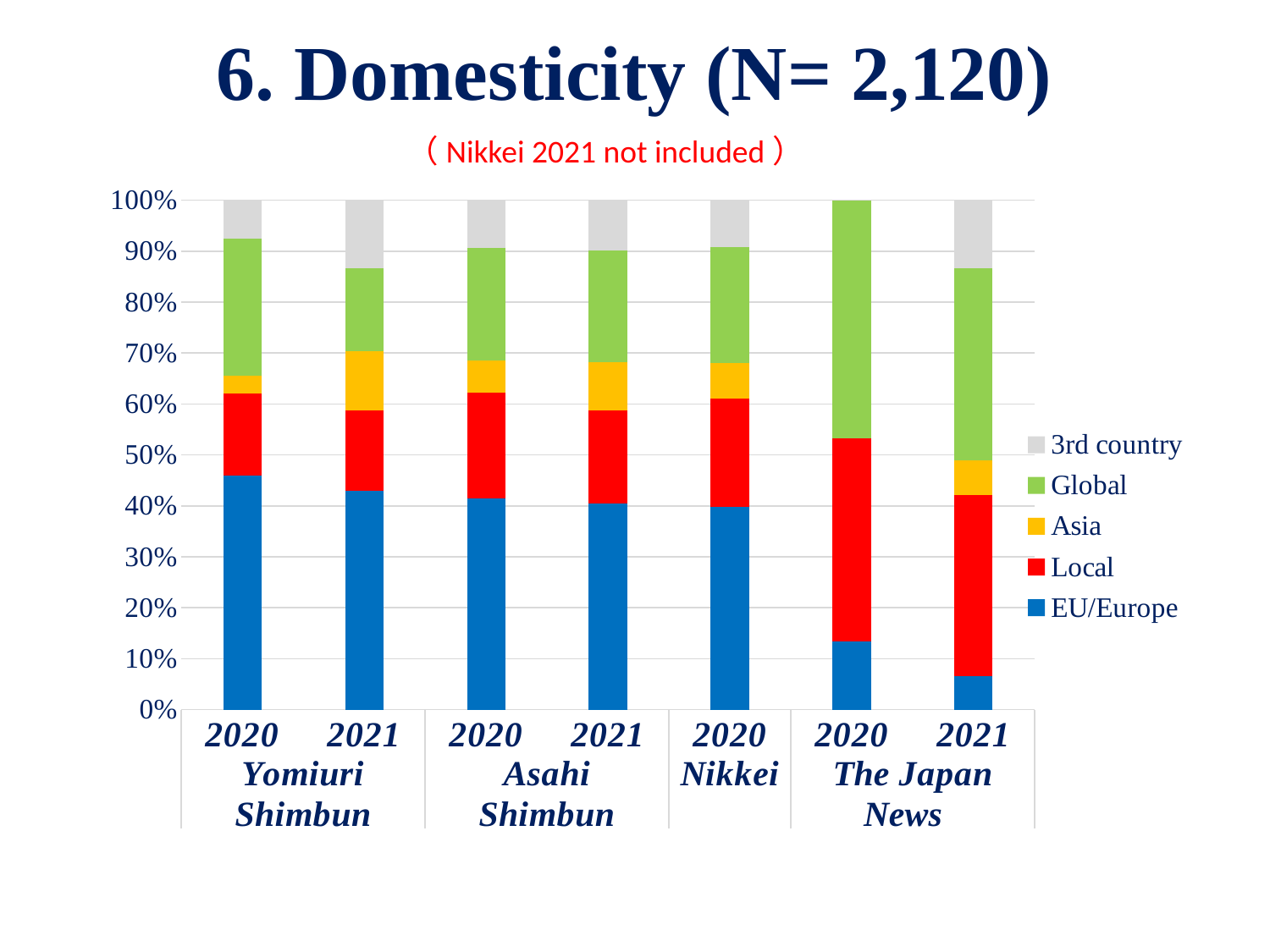
Which bar has no 3rd country segment? The Japan News 2020 Which has the larger Local segment: The Japan News 2020 or Asahi Shimbun 2020? The Japan News 2020 Is the EU/Europe share for Yomiuri Shimbun 2020 greater or less than 40%? greater How many bars are plotted in the chart? 7 Is the EU/Europe share for The Japan News 2021 greater or less than 10%? less Which newspaper and year has the smallest EU/Europe segment? The Japan News 2021 What kind of chart is shown on the slide? Stacked bar chart Which newspaper and year has the largest Local segment? The Japan News 2020 Which year of Nikkei is noted as not included in the chart? 2021 Is the EU/Europe share for The Japan News 2020 greater or less than 10%? greater Which has the larger EU/Europe segment: Yomiuri Shimbun 2020 or The Japan News 2020? Yomiuri Shimbun 2020 How many series does the legend list? 5